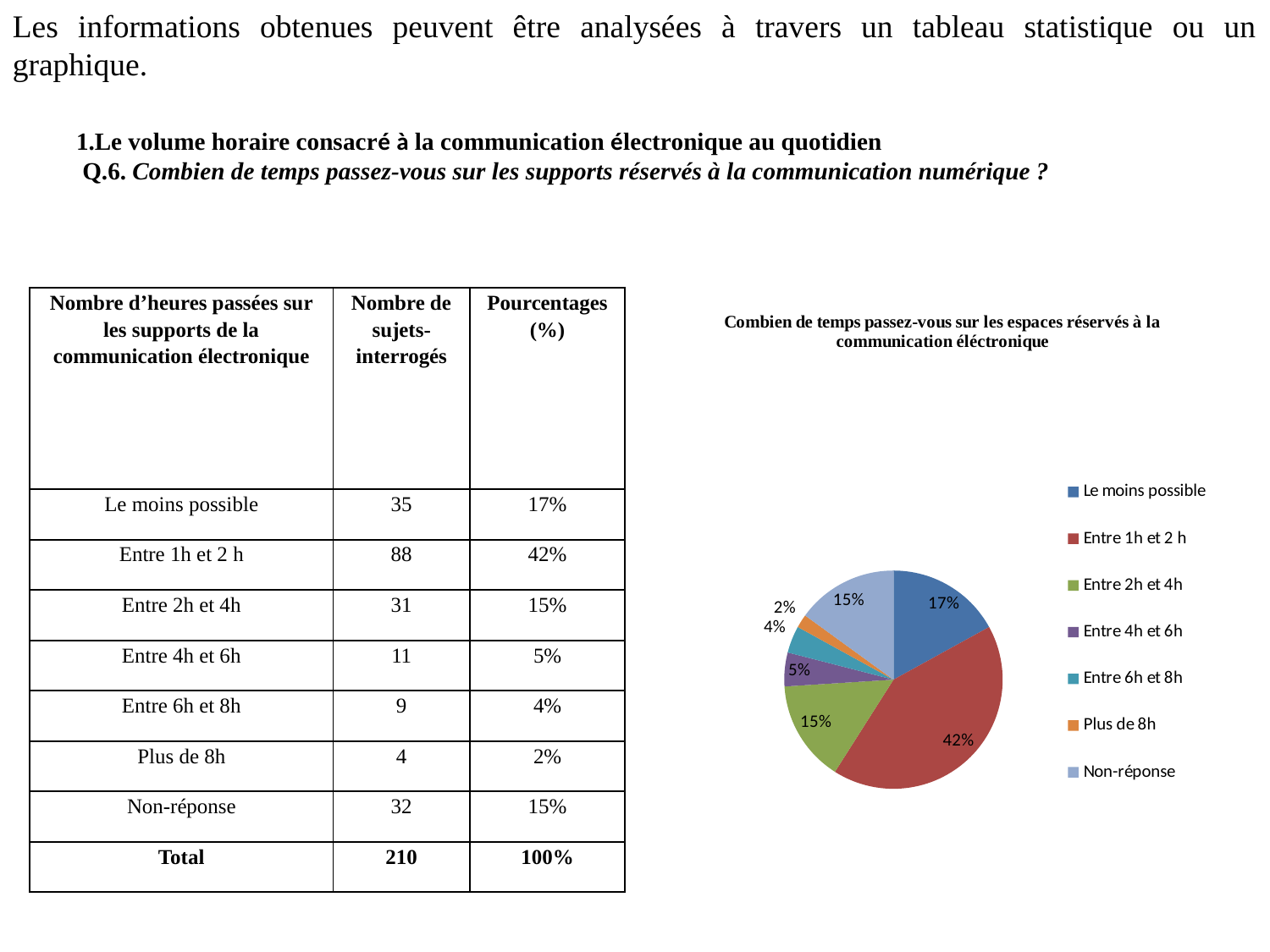
How many entries does the legend of the pie chart list? 7 How many slices does the pie chart have? 7 What percentage does the pie chart show for 'Entre 1h et 2 h'? 42% What percentage does the pie chart show for 'Le moins possible'? 17% What percentage does the pie chart show for 'Plus de 8h'? 2% Which category has the smallest slice in the pie chart? Plus de 8h What kind of chart is shown on the slide? pie chart In the pie chart, what is the difference in percentage points between 'Entre 1h et 2 h' and 'Le moins possible'? 25 What percentage does the pie chart show for 'Entre 6h et 8h'? 4% What is the title of the pie chart? Combien de temps passez-vous sur les espaces réservés à la communication éléctronique Which category has the largest slice in the pie chart? Entre 1h et 2 h In the pie chart, which is larger: the slice for 'Entre 4h et 6h' or the slice for 'Entre 6h et 8h'? Entre 4h et 6h